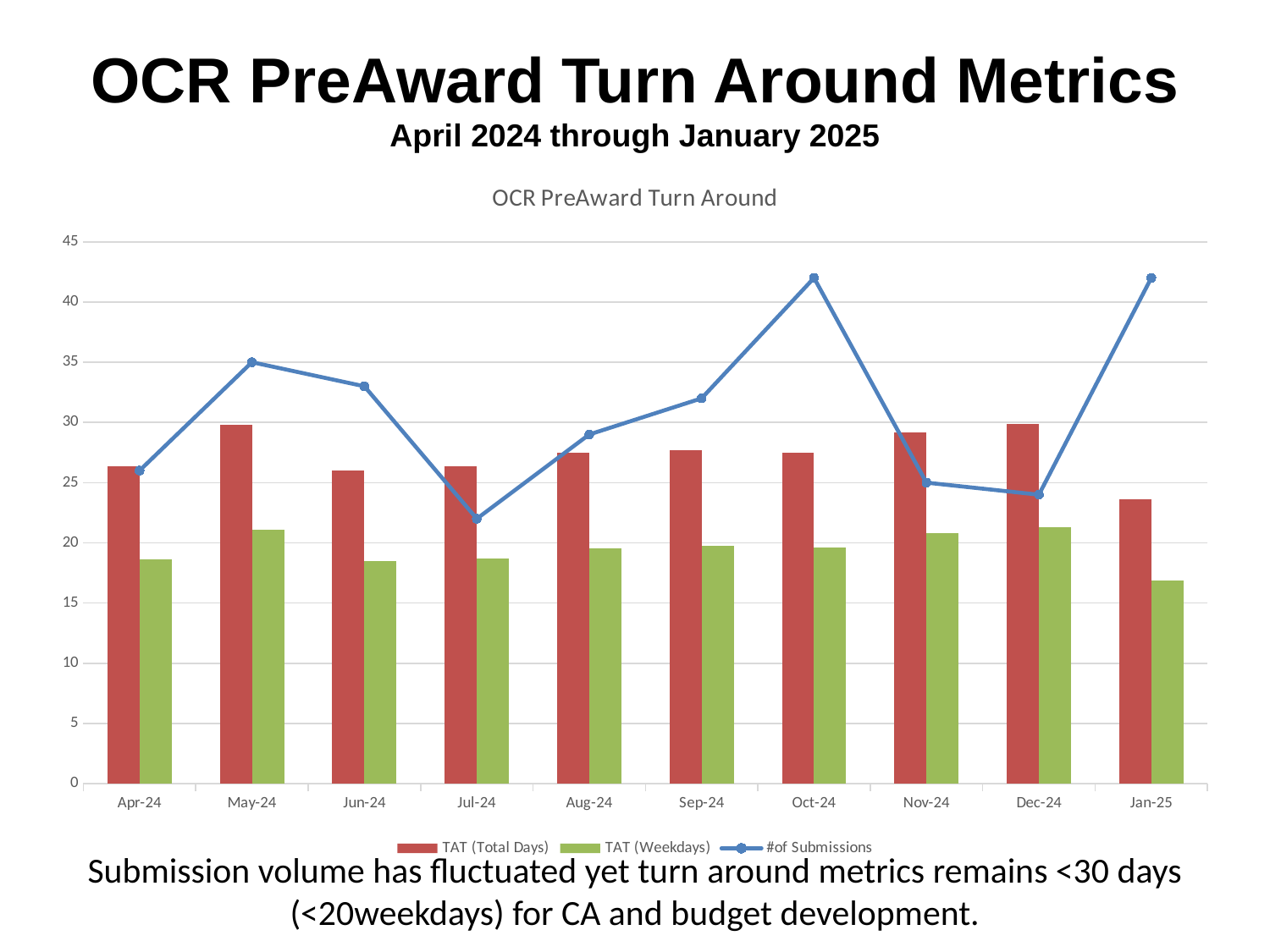
Which month has the lowest TAT (Total Days)? Jan-25 Is the number of submissions for Oct-24 greater or less than 40? greater How many series does the legend list? 3 Which month has more submissions, May-24 or Jul-24? May-24 What kind of chart is this? Combined bar and line chart Is the number of submissions for Jul-24 greater or less than 25? less Is the TAT (Weekdays) value for Dec-24 greater or less than 20? greater Which month has the lowest number of submissions? Jul-24 What is the title of the chart? OCR PreAward Turn Around Does the number of submissions rise or fall from Jul-24 to Oct-24? rise How many months are shown on the x axis? 10